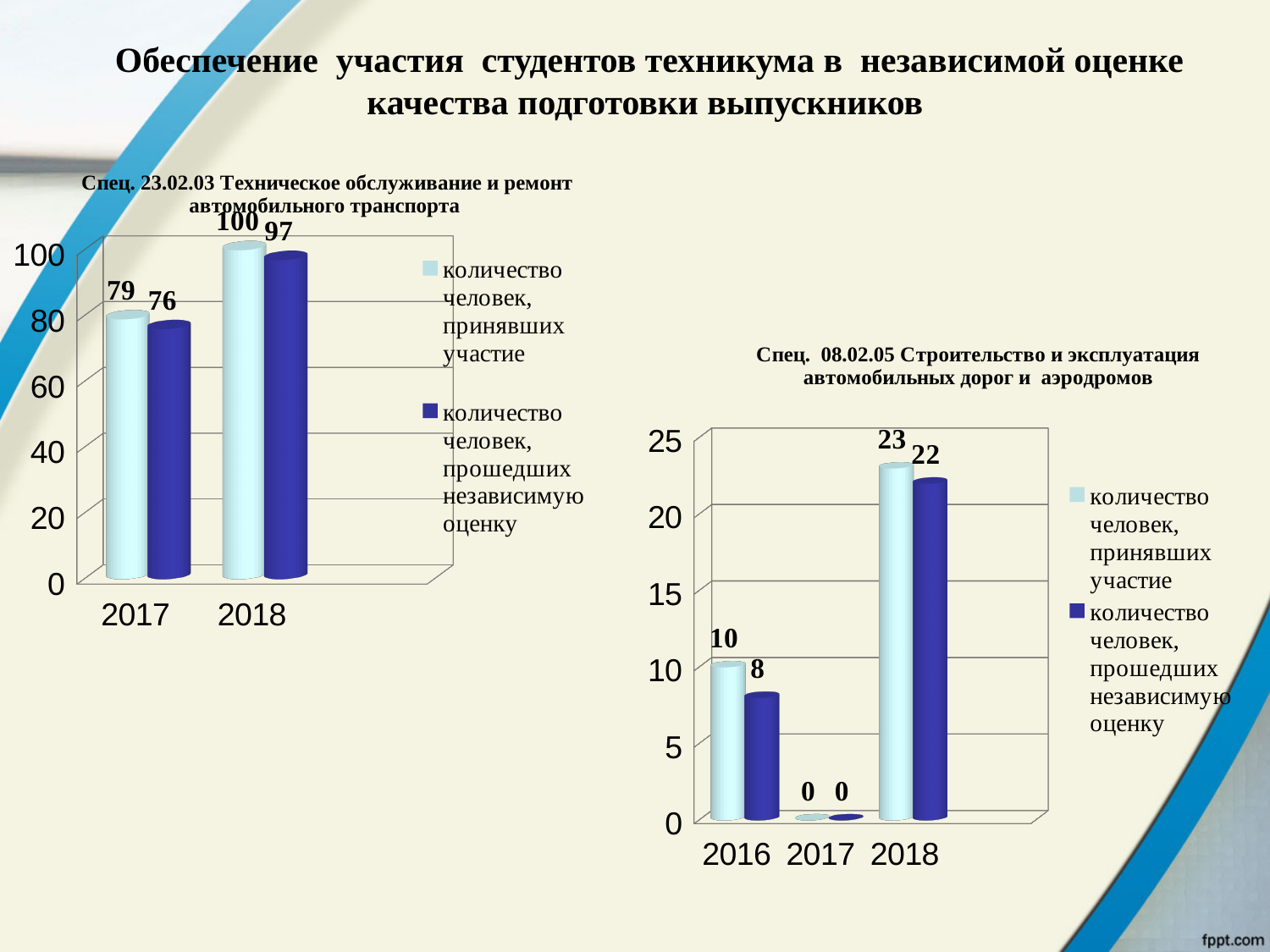
In the left chart (Спец. 23.02.03), does 'количество человек, принявших участие' rise or fall from 2017 to 2018? rise In the right chart (Спец. 08.02.05), what is the difference between 'количество человек, принявших участие' in 2018 and in 2016? 13 In the right chart (Спец. 08.02.05), how many years are shown on the x axis? 3 In the left chart (Спец. 23.02.03), how many series does the legend list? 2 In the right chart (Спец. 08.02.05), what is the value for 'количество человек, прошедших независимую оценку' in 2016? 8 In the left chart (Спец. 23.02.03), what is the value for 'количество человек, принявших участие' in 2017? 79 In the right chart (Спец. 08.02.05), which year has the lowest value for 'количество человек, прошедших независимую оценку'? 2017 In the left chart (Спец. 23.02.03), what is the value for 'количество человек, прошедших независимую оценку' in 2018? 97 What type of chart is the left chart (Спец. 23.02.03)? bar chart In the right chart (Спец. 08.02.05), what is the value for 'количество человек, принявших участие' in 2018? 23 In the left chart (Спец. 23.02.03), what is the difference between the two series in 2018? 3 In the right chart (Спец. 08.02.05), which year has the highest value for 'количество человек, принявших участие'? 2018